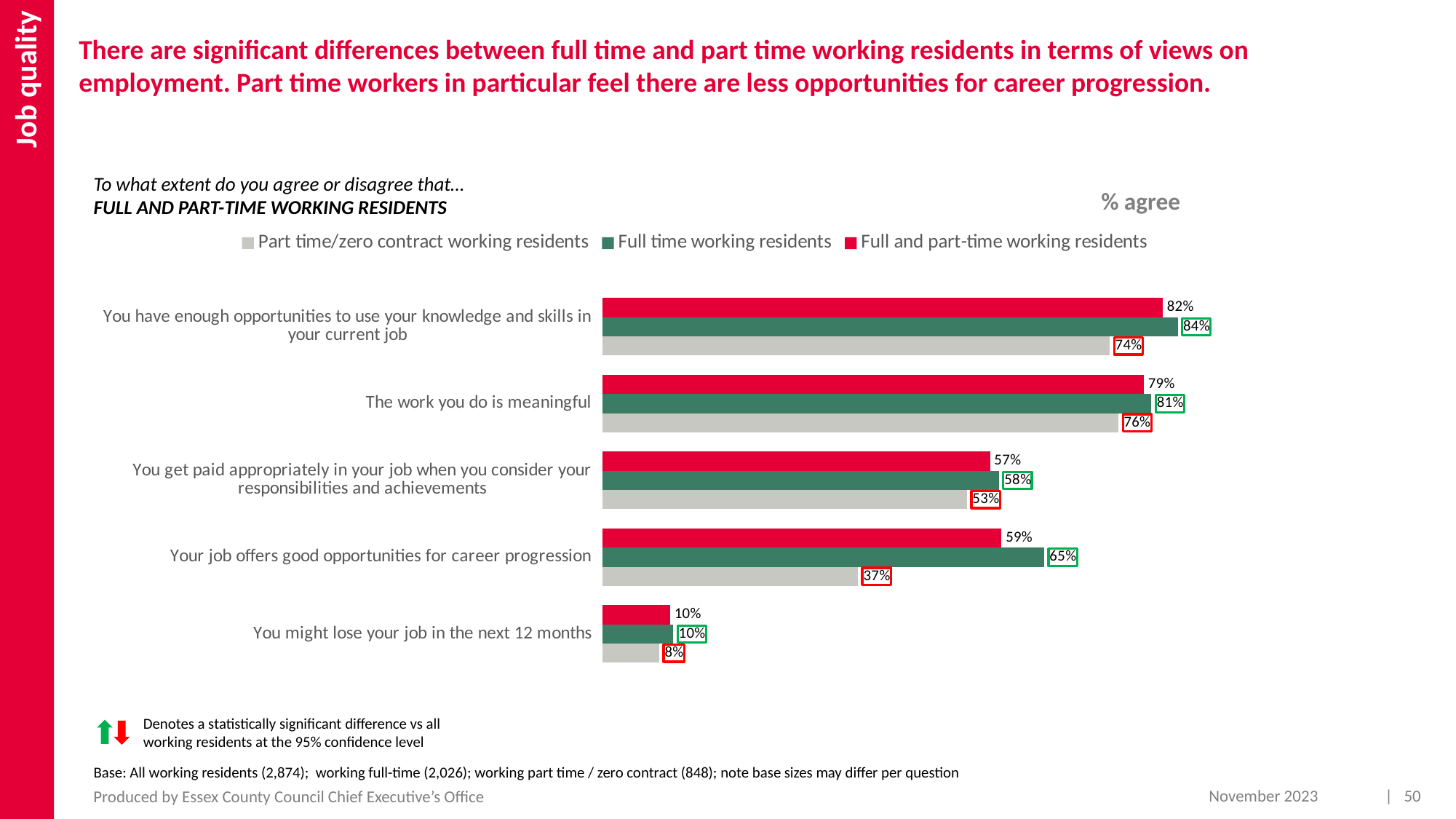
Which statement has the lowest % agree among full time working residents? You might lose your job in the next 12 months What percentage of part time/zero contract working residents agree that they might lose their job in the next 12 months? 8% How many statements are shown on the chart? 5 What percentage of full time working residents agree that they have enough opportunities to use their knowledge and skills in their current job? 84% What percentage of full and part-time working residents agree that the work they do is meaningful? 79% What type of chart is shown on the slide? Bar chart What is the difference between full time and part time/zero contract working residents' % agree that their job offers good opportunities for career progression? 28% What percentage of part time/zero contract working residents agree that their job offers good opportunities for career progression? 37% Which colour represents full time working residents in the chart? Green Which statement has the highest % agree among part time/zero contract working residents? The work you do is meaningful How many series does the legend list? 3 For 'You get paid appropriately in your job when you consider your responsibilities and achievements', which group has the higher % agree: full time working residents or part time/zero contract working residents? Full time working residents